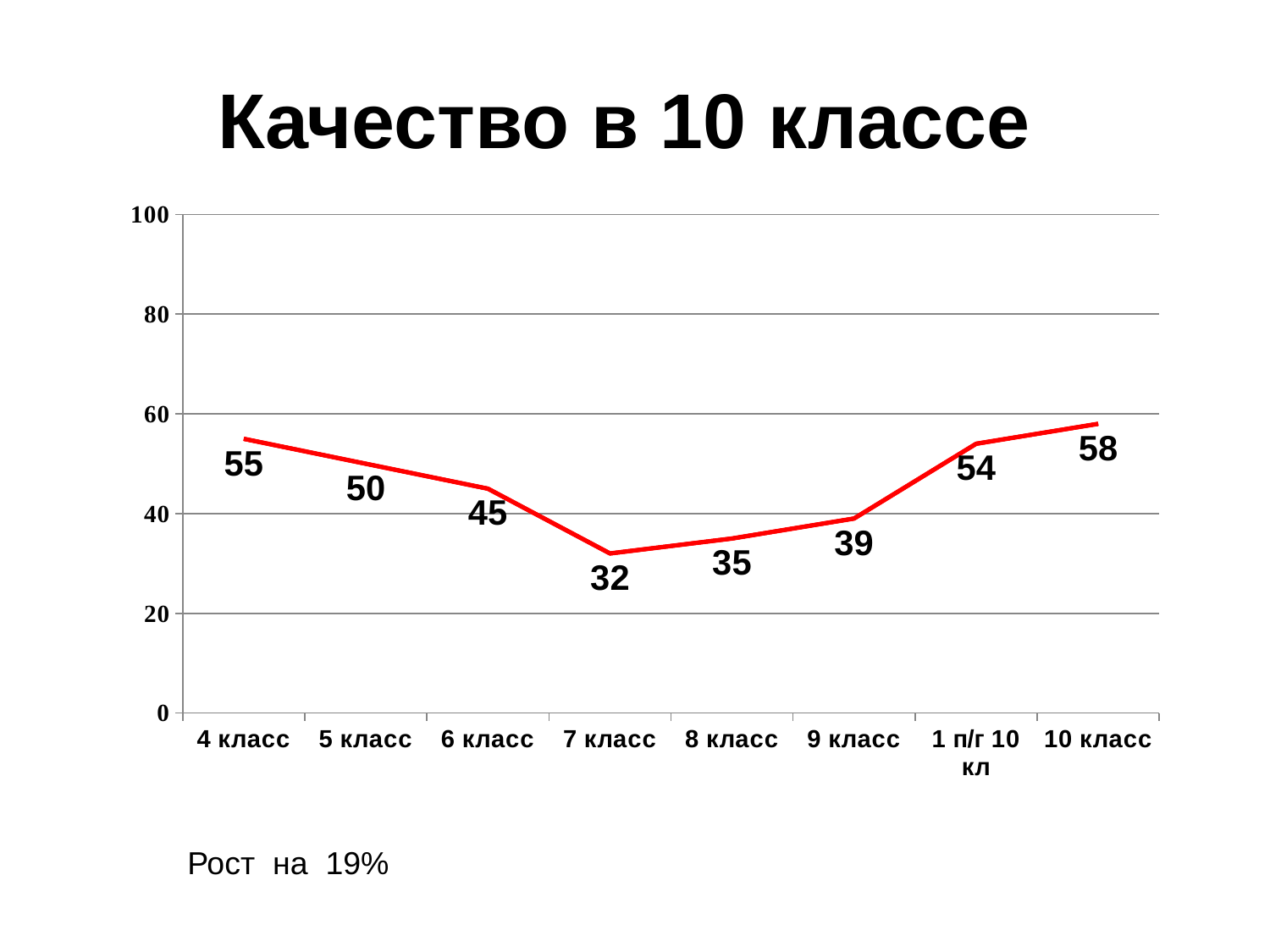
Which category has the highest value? 10 класс Do the values rise or fall from 4 класс to 7 класс? fall Is the value for 8 класс greater or less than 40? less What is the difference between the values for 10 класс and 7 класс? 26 What kind of chart is shown on the slide? line chart Which category has the lowest value? 7 класс What is the value for 4 класс? 55 What is the value for 1 п/г 10 кл? 54 What is the value for 7 класс? 32 Which is larger, the value for 5 класс or the value for 9 класс? 5 класс How many categories are plotted on the x axis? 8 What is the title of the chart? Качество в 10 классе